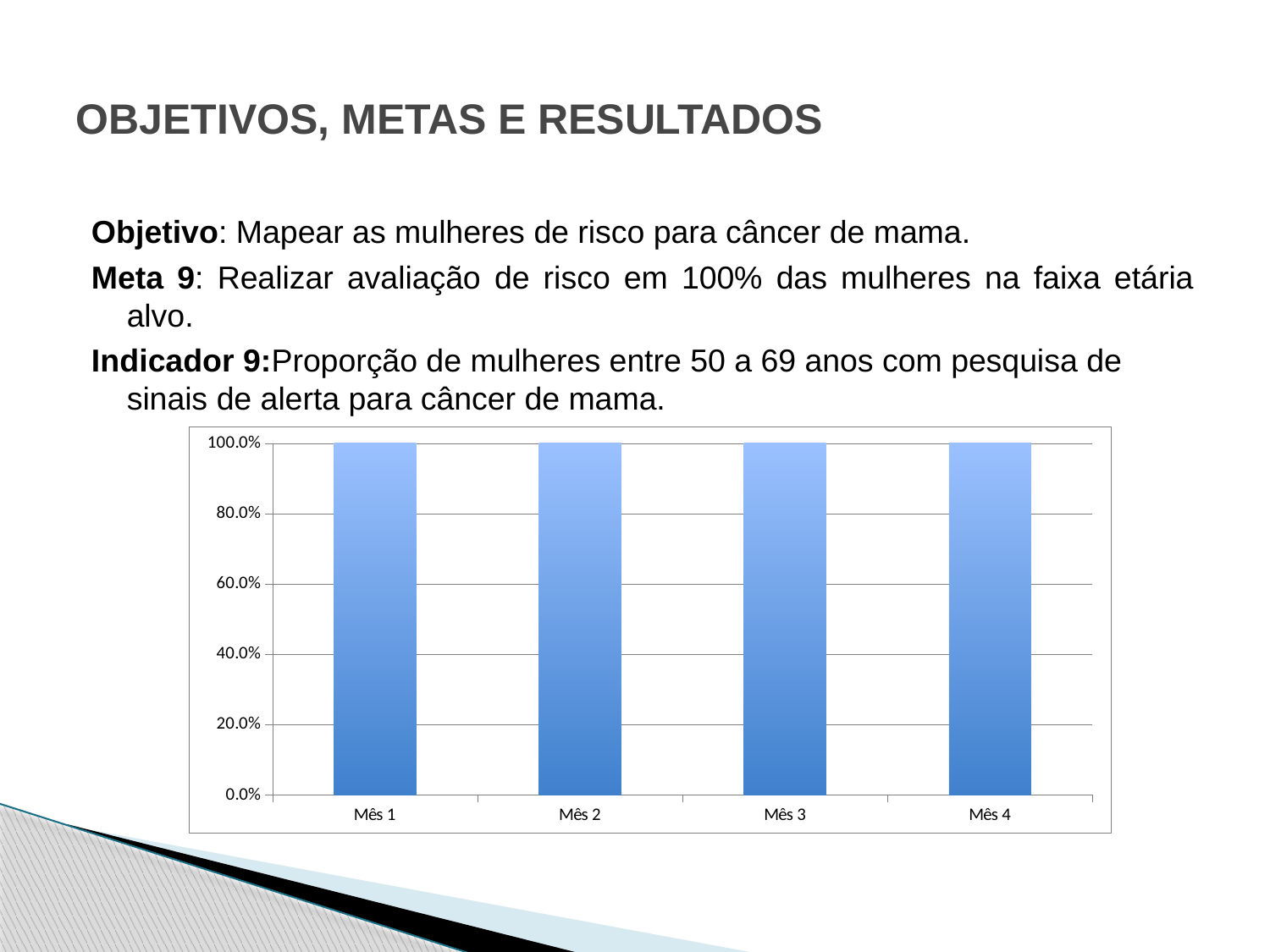
What is the highest value shown on the y axis? 100.0% What is the value for Mês 3? 100.0% What kind of chart is shown on the slide? bar chart Is the value for Mês 1 greater or less than 60.0%? greater What is the label of the first category on the x axis? Mês 1 How many categories (months) are plotted on the chart? 4 Do the values rise, fall, or stay the same from Mês 1 to Mês 4? stay the same What is the value for Mês 1? 100.0% What is the value for Mês 4? 100.0% What is the difference between the values for Mês 4 and Mês 1? 0.0% What is the value for Mês 2? 100.0% Is the value for Mês 3 greater or less than 80.0%? greater